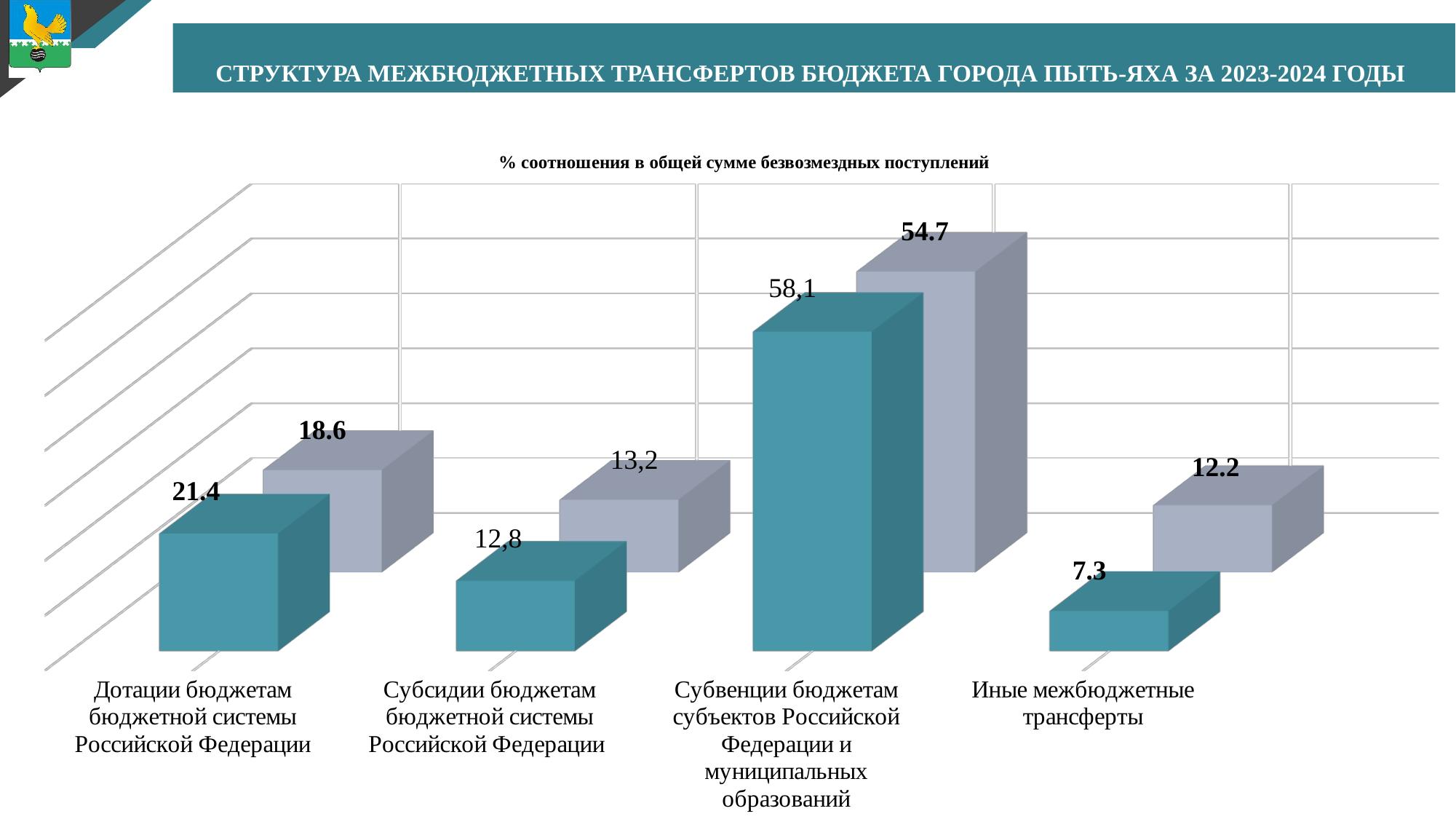
What is the value of the teal bar for «Иные межбюджетные трансферты»? 7.3 Which category has the highest teal bar? Субвенции бюджетам субъектов Российской Федерации и муниципальных образований Which category has the lowest teal bar? Иные межбюджетные трансферты What is the value of the teal bar for «Дотации бюджетам бюджетной системы Российской Федерации»? 21.4 What is the difference between the teal and grey bars for «Субвенции бюджетам субъектов Российской Федерации и муниципальных образований»? 3.4 What kind of chart is shown on the slide? bar chart What is the title of the chart? % соотношения в общей сумме безвозмездных поступлений What is the value of the grey bar for «Субвенции бюджетам субъектов Российской Федерации и муниципальных образований»? 54.7 What is the value of the grey bar for «Субсидии бюджетам бюджетной системы Российской Федерации»? 13,2 For «Иные межбюджетные трансферты», which bar is larger, the teal one or the grey one? the grey one How many categories are shown on the x axis of the chart? 4 What is the difference between the teal and grey bars for «Дотации бюджетам бюджетной системы Российской Федерации»? 2.8